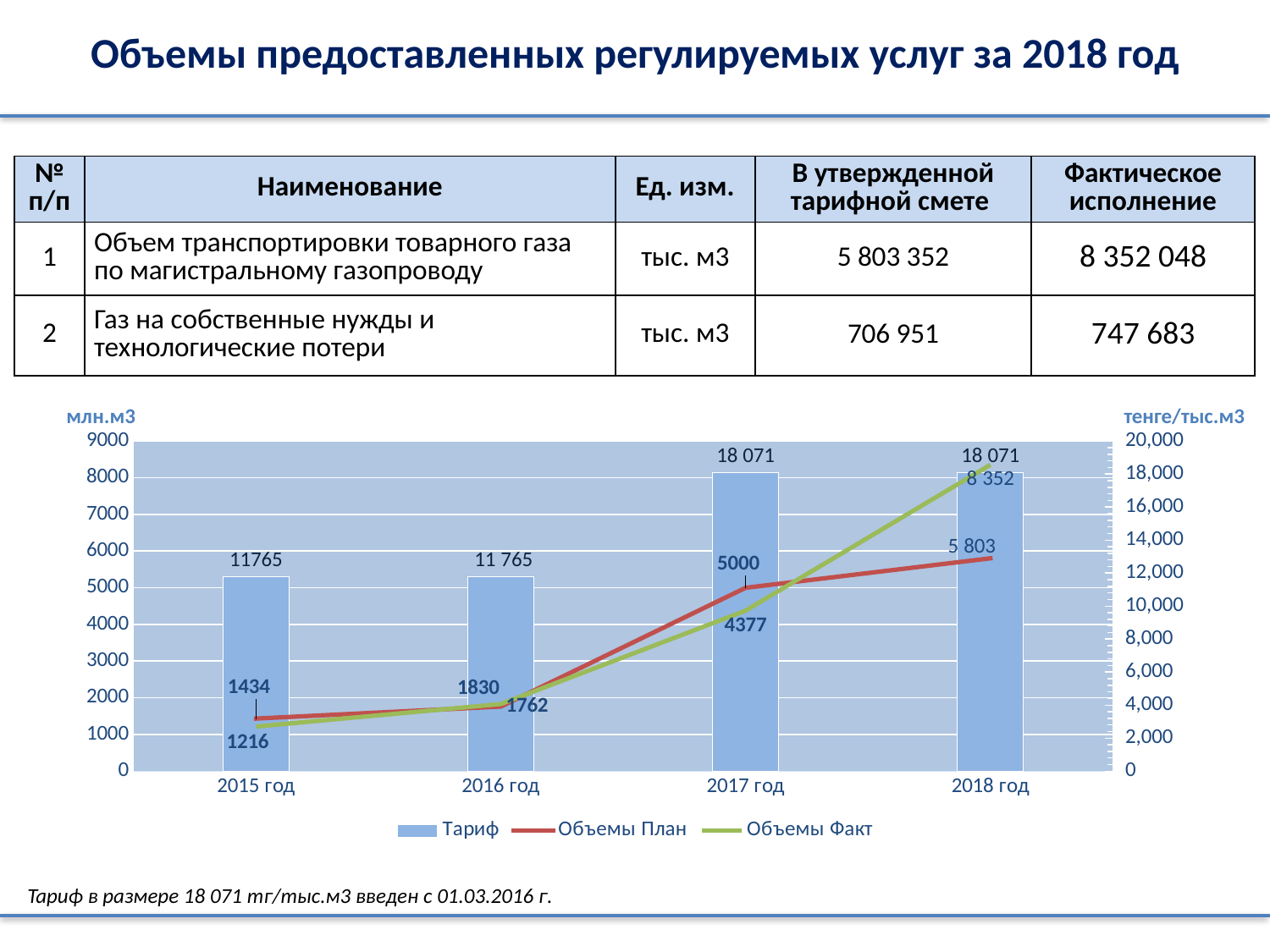
What is the value of Объемы Факт for 2016 год? 1830 How many years are shown on the x axis of the chart? 4 What is the value of Объемы Факт for 2018 год? 8 352 Does Объемы Факт rise or fall from 2015 год to 2018 год? rise How many series does the chart legend list? 3 What is the value of Объемы План for 2017 год? 5000 Is the Тариф value for 2017 год greater or less than 16,000 on the right axis? greater What is the difference between Объемы Факт and Объемы План in 2018 год? 2 549 In which year is Объемы Факт highest? 2018 год In which year is Объемы План lowest? 2015 год What is the Тариф value shown for 2015 год? 11765 Which is larger in 2017 год, Объемы План or Объемы Факт? Объемы План